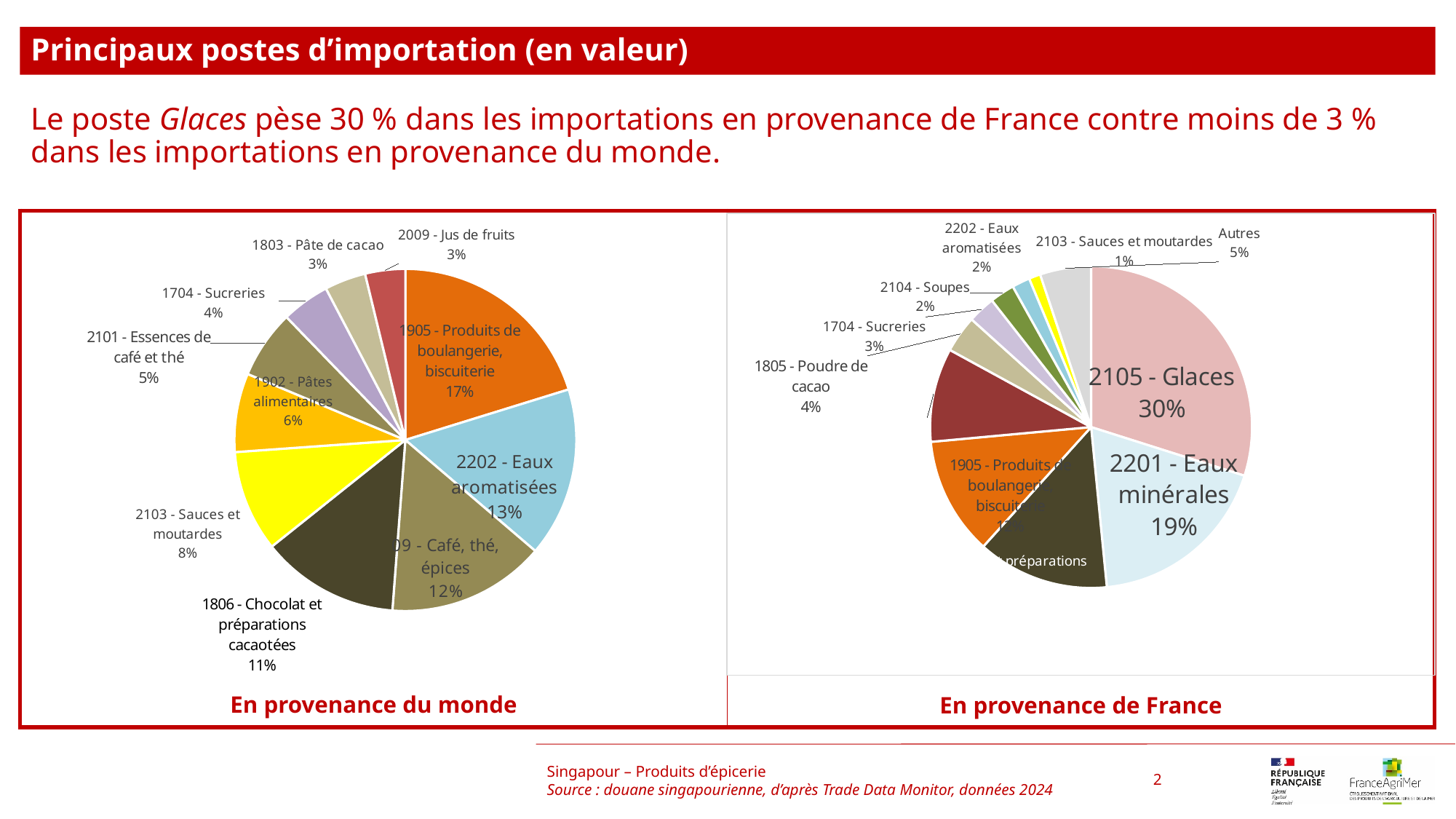
In the 'En provenance de France' pie chart, which category has the largest share? 2105 - Glaces In the 'En provenance de France' pie chart, what share does 'Autres' have? 5% What kind of chart is used on the slide for 'En provenance du monde'? Pie chart In the 'En provenance du monde' pie chart, what is the difference in percentage points between '1905 - Produits de boulangerie, biscuiterie' and '2202 - Eaux aromatisées'? 4 percentage points In the 'En provenance du monde' pie chart, what share does '1905 - Produits de boulangerie, biscuiterie' have? 17% In the 'En provenance du monde' pie chart, what share does '2202 - Eaux aromatisées' have? 13% In the 'En provenance du monde' pie chart, what share does '1806 - Chocolat et préparations cacaotées' have? 11% In the 'En provenance du monde' pie chart, which category has the largest share? 1905 - Produits de boulangerie, biscuiterie In the 'En provenance de France' pie chart, what share does '2201 - Eaux minérales' have? 19% In the 'En provenance du monde' pie chart, which is larger: '2103 - Sauces et moutardes' or '1902 - Pâtes alimentaires'? 2103 - Sauces et moutardes How many pie charts are shown on the slide? 2 In the 'En provenance de France' pie chart, what share does '2105 - Glaces' have? 30%